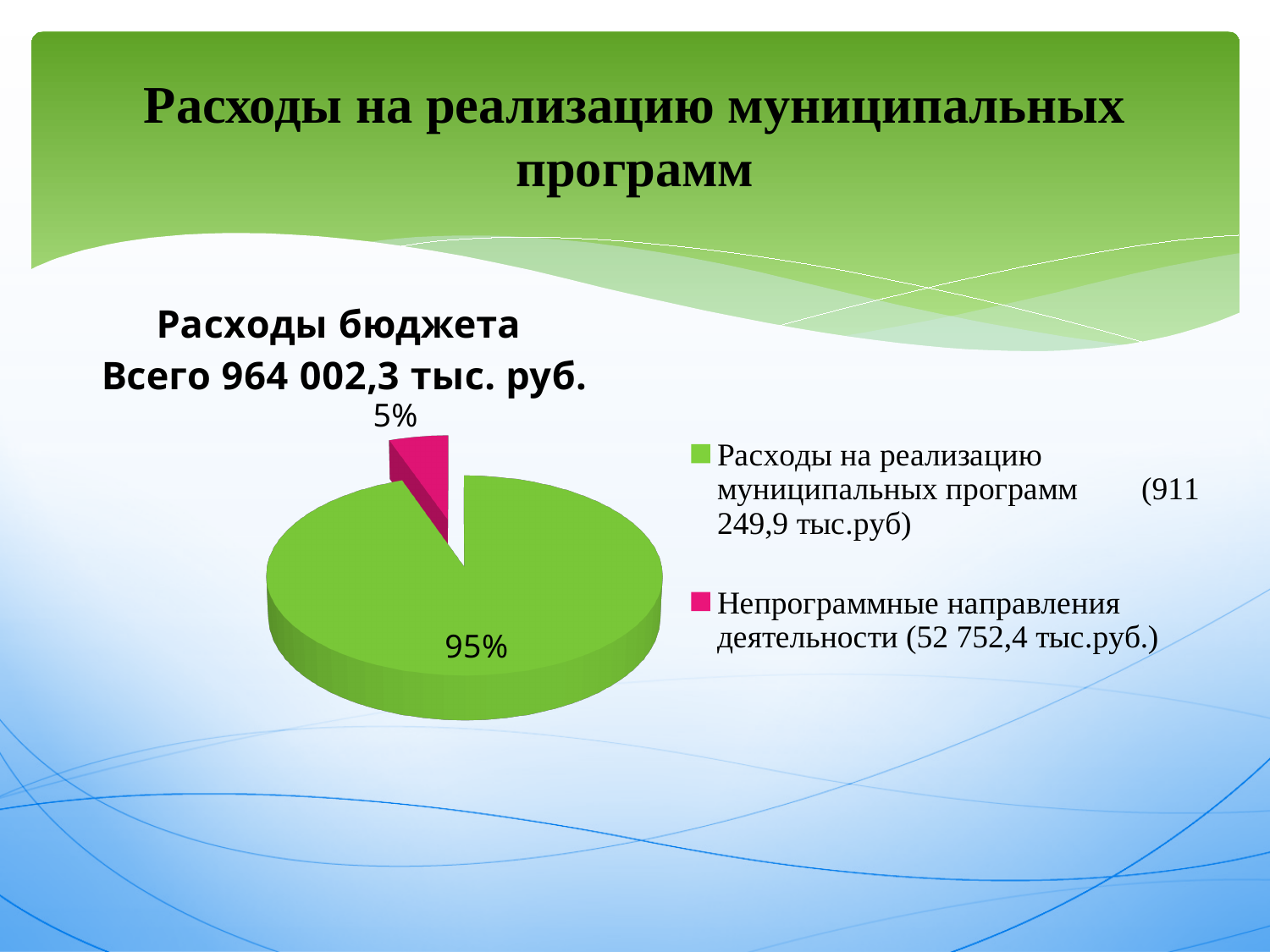
What amount does the legend give for "Непрограммные направления деятельности"? 52 752,4 тыс.руб. What share of the pie does "Непрограммные направления деятельности" take? 5% What is the difference in percentage points between the two slices of the pie? 90 percentage points Which is larger: the share for "Расходы на реализацию муниципальных программ" or the share for "Непрограммные направления деятельности"? Расходы на реализацию муниципальных программ What kind of chart is shown on the slide? Pie chart What share of the pie does "Расходы на реализацию муниципальных программ" take? 95% What colour is the slice for "Непрограммные направления деятельности"? Pink Which slice of the pie is the smallest? Непрограммные направления деятельности How many entries does the legend list? 2 Which slice of the pie is the largest? Расходы на реализацию муниципальных программ How many slices does the pie chart have? 2 What total amount is stated in the chart title? 964 002,3 тыс. руб.